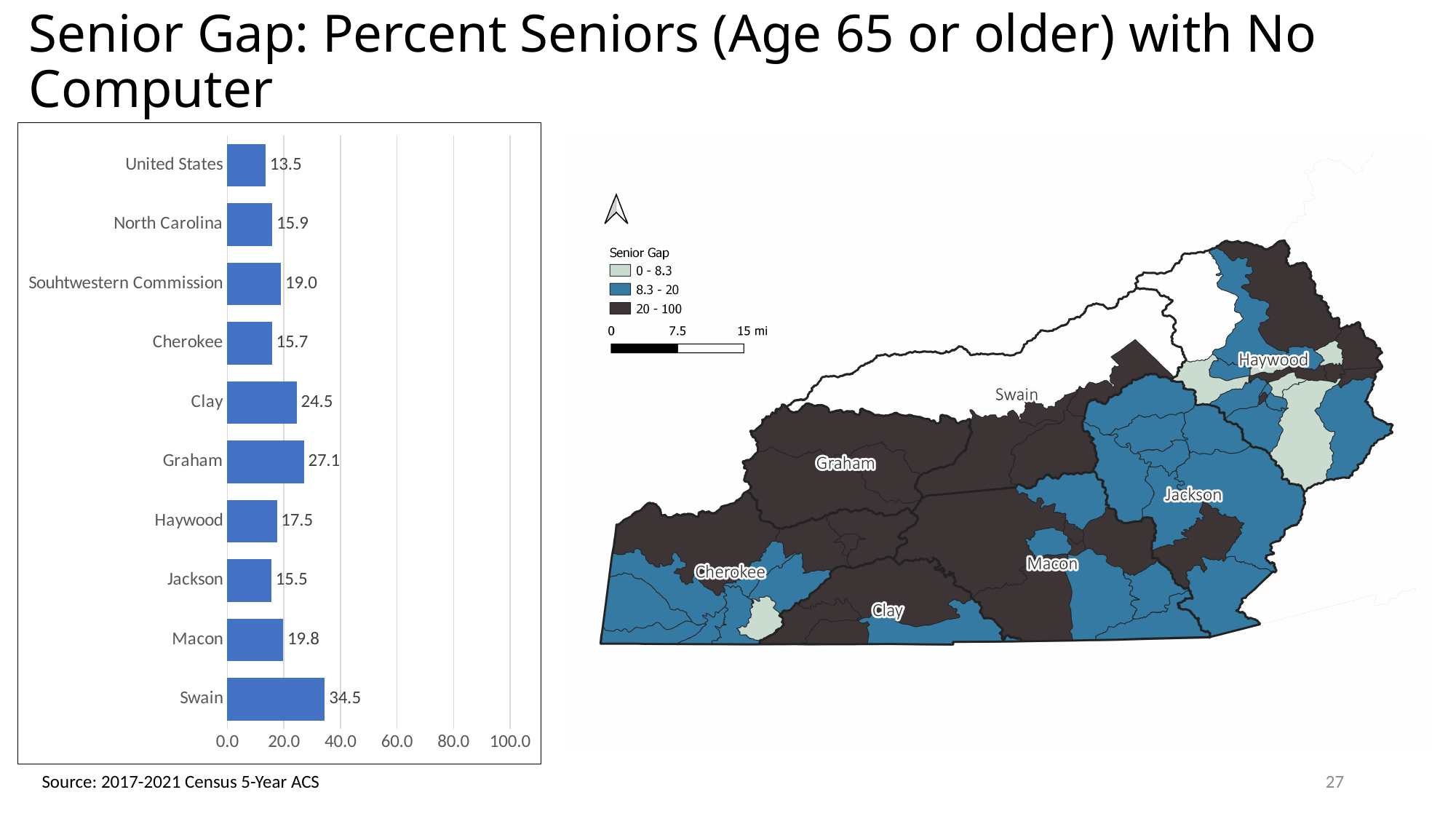
What is the value for Graham in the bar chart? 27.1 How many categories are shown in the bar chart? 10 What is the value for Macon in the bar chart? 19.8 What is the value for Swain in the bar chart? 34.5 In the bar chart, which is larger, the value for Macon or the value for Haywood? Macon Which category has the lowest value in the bar chart? United States Which category has the highest value in the bar chart? Swain What is the difference between the values for Clay and Cherokee in the bar chart? 8.8 What is the value for North Carolina in the bar chart? 15.9 What kind of chart is shown on the left of the slide? bar chart What is the difference between the values for Swain and Graham in the bar chart? 7.4 Is the value for Swain in the bar chart greater or less than 20.0? greater